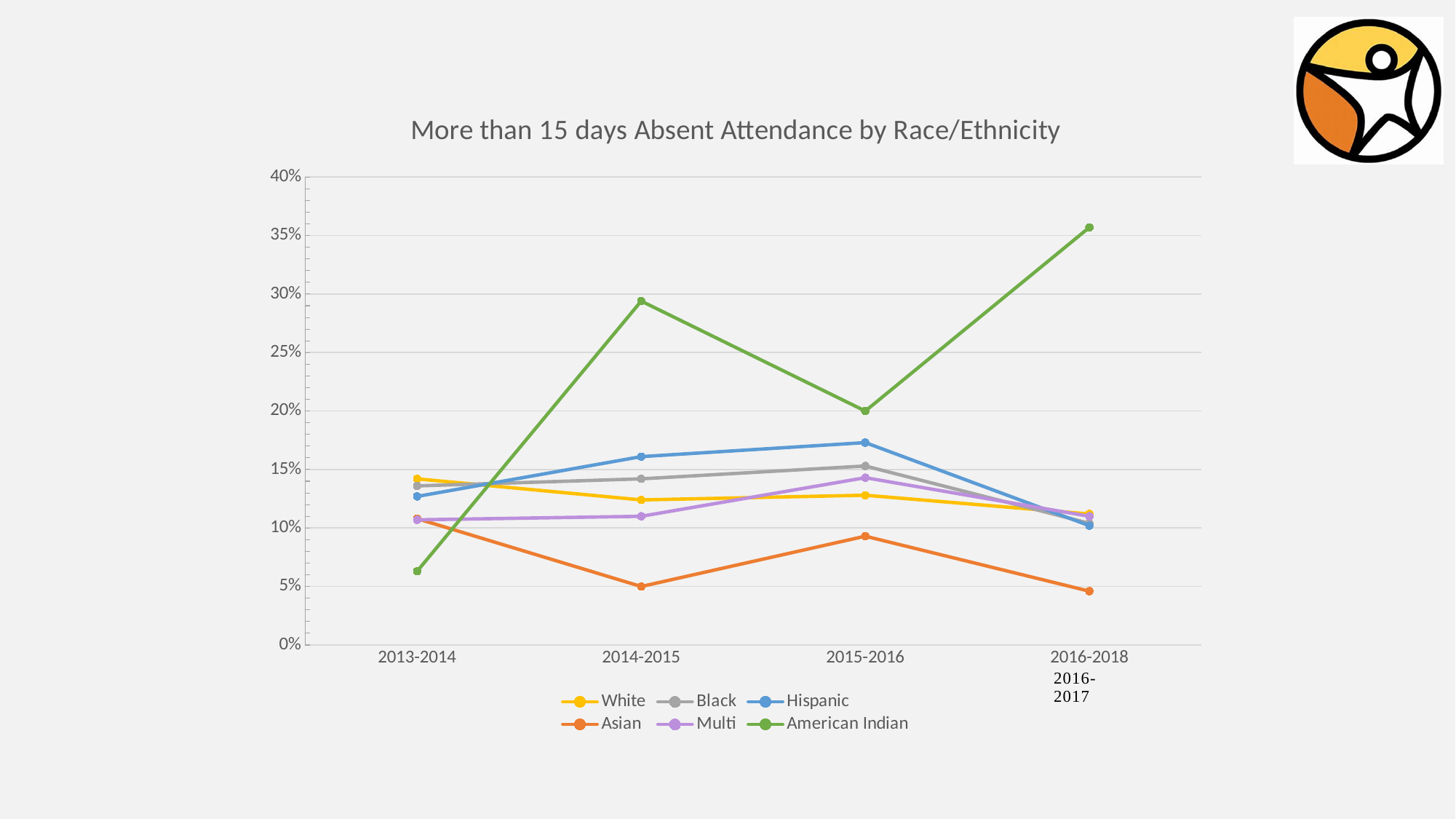
Which race/ethnicity has the lowest value in 2013-2014? American Indian In 2015-2016, which is larger, the value for Hispanic or the value for White? Hispanic Does the Hispanic line rise or fall from 2013-2014 to 2015-2016? rise What is the title of the chart? More than 15 days Absent Attendance by Race/Ethnicity Is the value for American Indian in 2016-2018 greater or less than 30%? greater How many school-year categories are shown on the x axis? 4 Which race/ethnicity has the lowest value in 2016-2018? Asian Is the value for Asian in 2014-2015 greater or less than 10%? less Which race/ethnicity has the highest value in 2016-2018? American Indian How many series does the legend list? 6 Is the value for American Indian in 2014-2015 greater or less than 25%? greater What kind of chart is shown on the slide? line chart